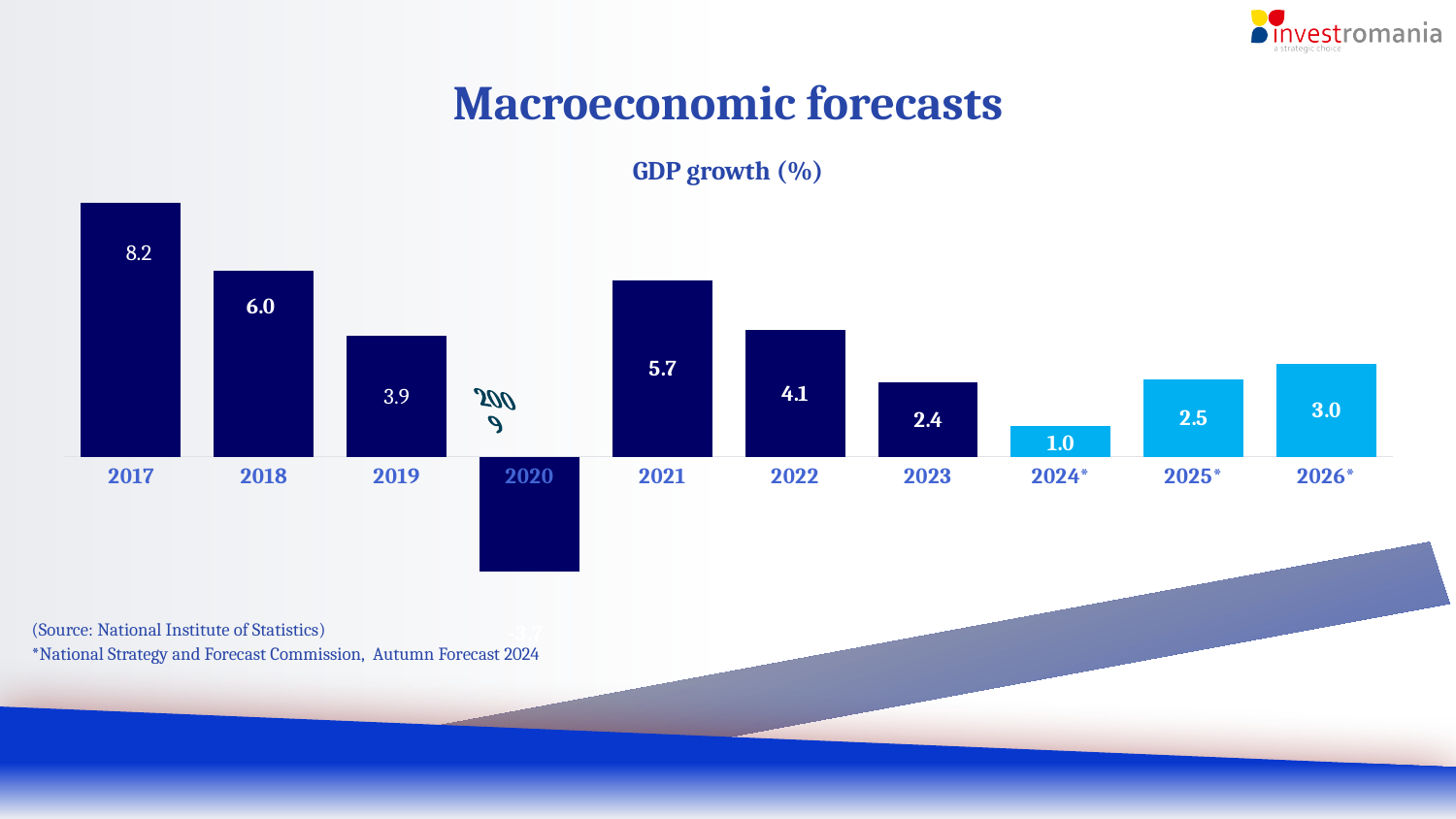
Which year has the lowest GDP growth value? 2020 Which year has the larger GDP growth value, 2021 or 2022? 2021 Do the GDP growth values rise or fall from 2024* to 2026*? Rise What is the GDP growth value for 2021? 5.7 How many years are shown on the chart? 10 What is the GDP growth value for 2024*? 1.0 What is the GDP growth value for 2017? 8.2 What is the title of the chart? GDP growth (%) What kind of chart is shown on the slide? Bar chart Which year has the highest GDP growth value? 2017 What is the GDP growth value for 2026*? 3.0 What is the difference between the GDP growth values for 2017 and 2018? 2.2